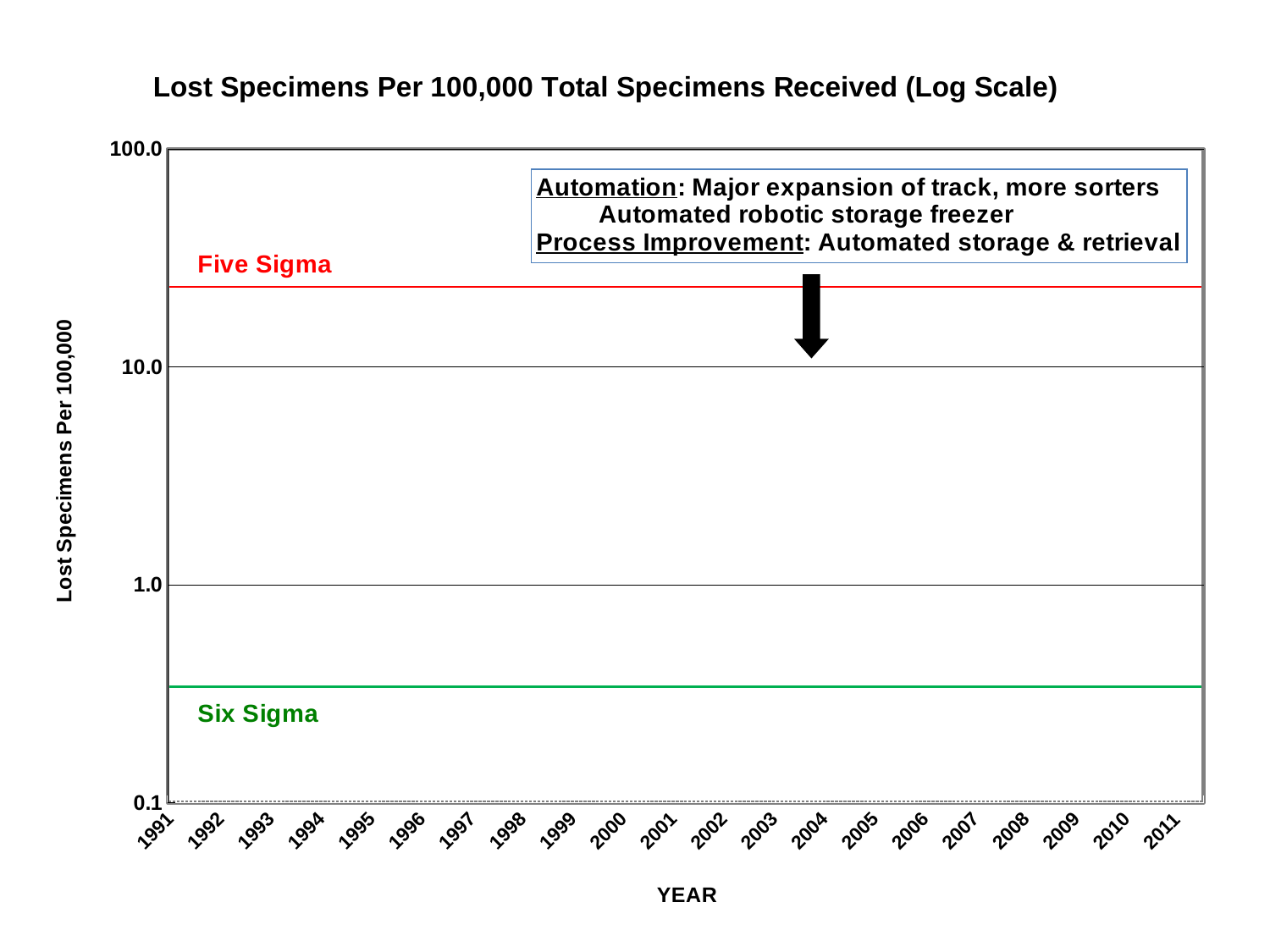
Is the Five Sigma reference line greater or less than 10.0 on the y axis? greater Which reference line sits higher on the chart, Five Sigma or Six Sigma? Five Sigma How many years are labelled along the x axis of the chart? 21 Is the Six Sigma reference line greater or less than 1.0 on the y axis? less What is the title of the chart? Lost Specimens Per 100,000 Total Specimens Received (Log Scale) What is the label of the x axis? YEAR